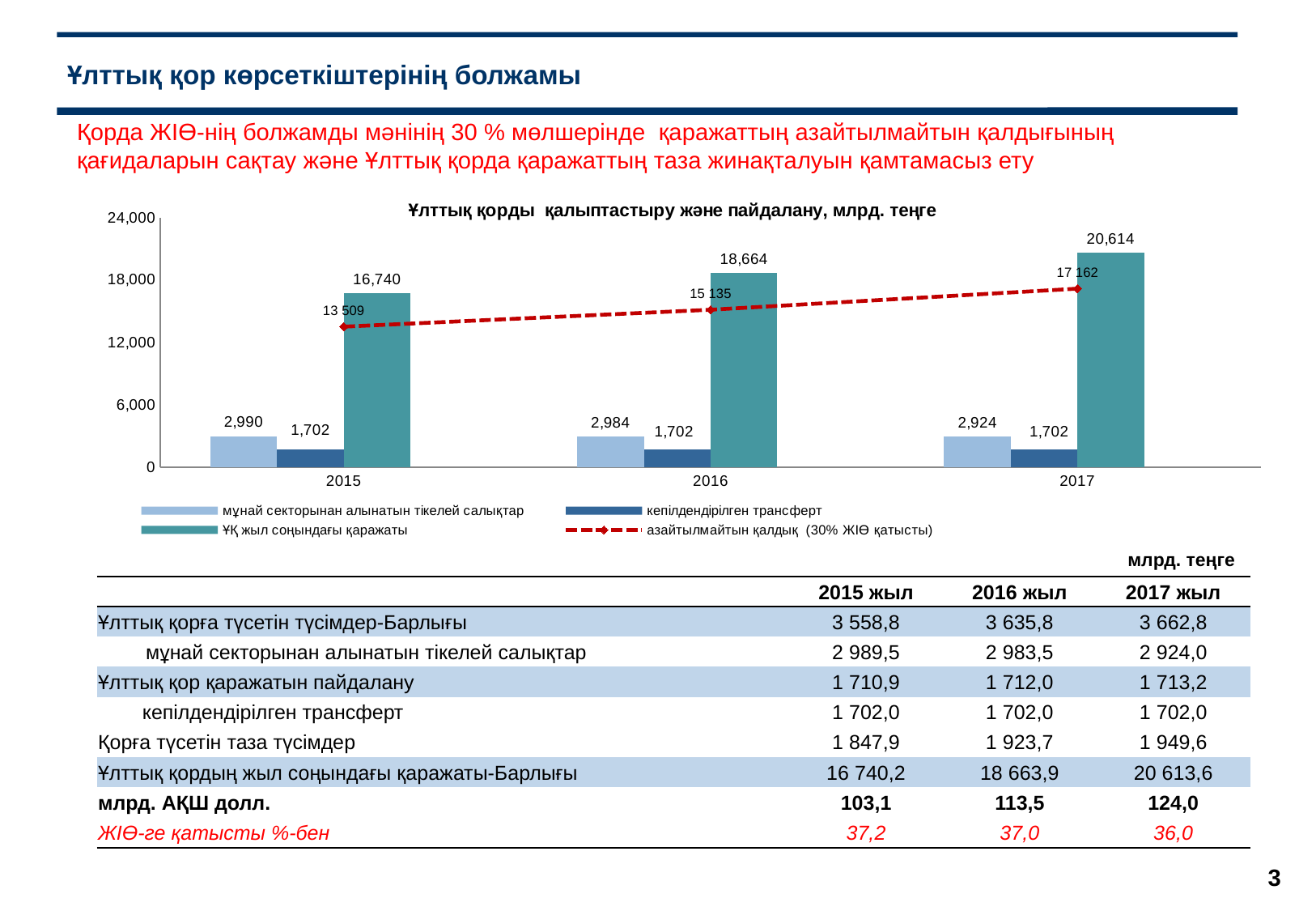
What is the value of азайтылмайтын қалдық (30% ЖІӨ қатысты) for 2016? 15 135 What is the value of мұнай секторынан алынатын тікелей салықтар for 2015? 2,990 How many years are shown on the x axis of the chart? 3 What type of chart is shown on the slide? Bar chart with a line What is the value of ҰҚ жыл соңындағы қаражаты for 2017? 20,614 In which year is ҰҚ жыл соңындағы қаражаты the highest? 2017 What is the value of кепілдендірілген трансферт for 2016? 1,702 How many series does the chart legend list? 4 What is the difference between ҰҚ жыл соңындағы қаражаты in 2017 and in 2015? 3,874 In which year is мұнай секторынан алынатын тікелей салықтар the lowest? 2017 Does азайтылмайтын қалдық (30% ЖІӨ қатысты) rise or fall from 2015 to 2017? Rise Which is larger in 2016: ҰҚ жыл соңындағы қаражаты or азайтылмайтын қалдық (30% ЖІӨ қатысты)? ҰҚ жыл соңындағы қаражаты